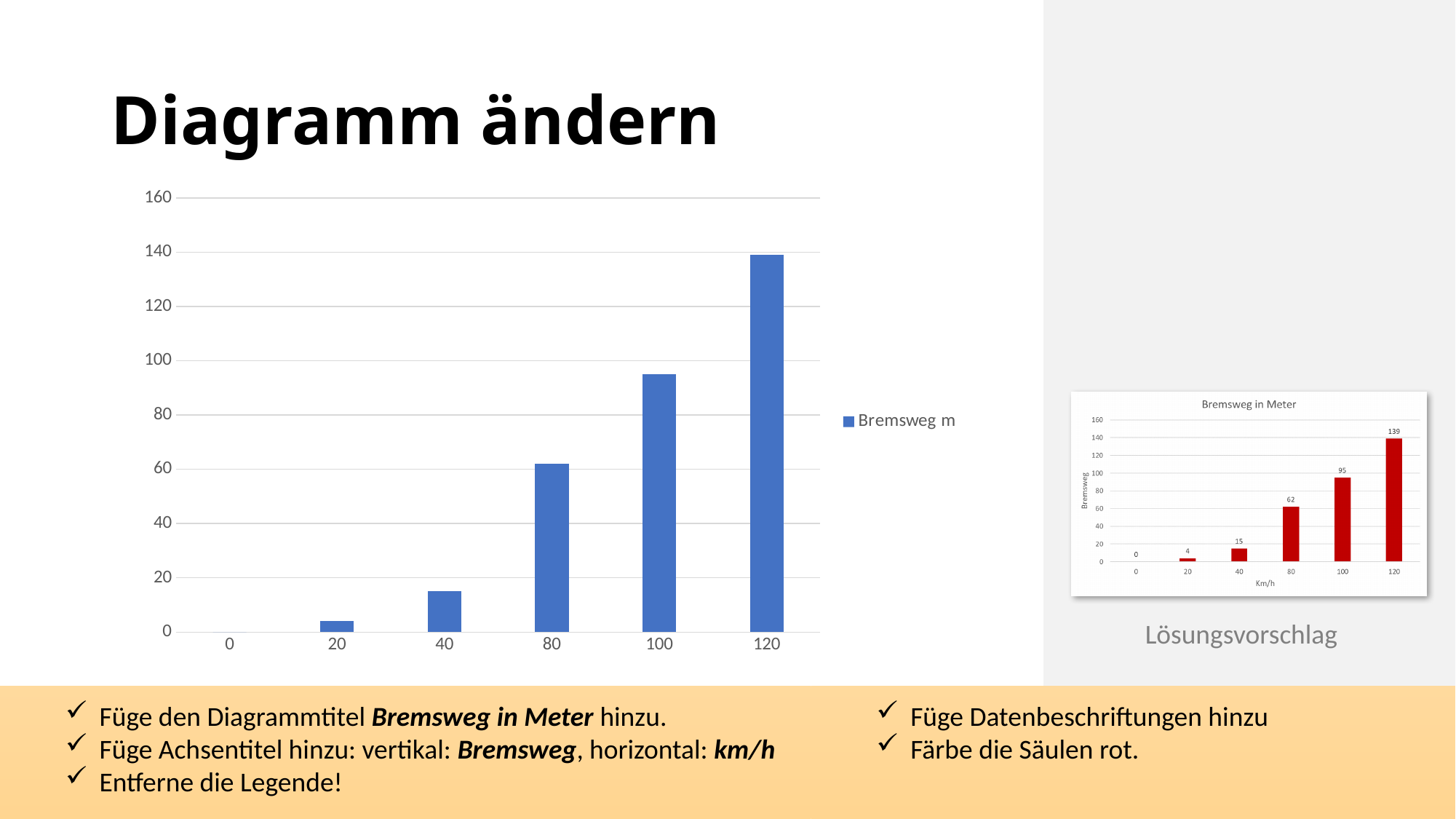
In the small chart titled 'Bremsweg in Meter', what is the value for 120? 139 What kind of chart is the large chart on the left? bar chart How many categories are shown on the x axis of the large blue bar chart on the left? 6 In the large blue bar chart on the left, which is larger, the value for 80 or the value for 40? 80 In the large blue bar chart on the left, is the value for 40 greater or less than 20? less In the small chart titled 'Bremsweg in Meter', which category has the highest value? 120 What is the legend entry shown next to the large blue bar chart on the left? Bremsweg m In the large blue bar chart on the left, is the value for 100 greater or less than 80? greater In the small chart titled 'Bremsweg in Meter', what is the value for 20? 4 In the large blue bar chart on the left, do the values rise or fall as the x axis goes from 0 to 120? rise In the small chart titled 'Bremsweg in Meter', what is the value for 80? 62 In the small chart titled 'Bremsweg in Meter', what is the difference between the values for 100 and 80? 33